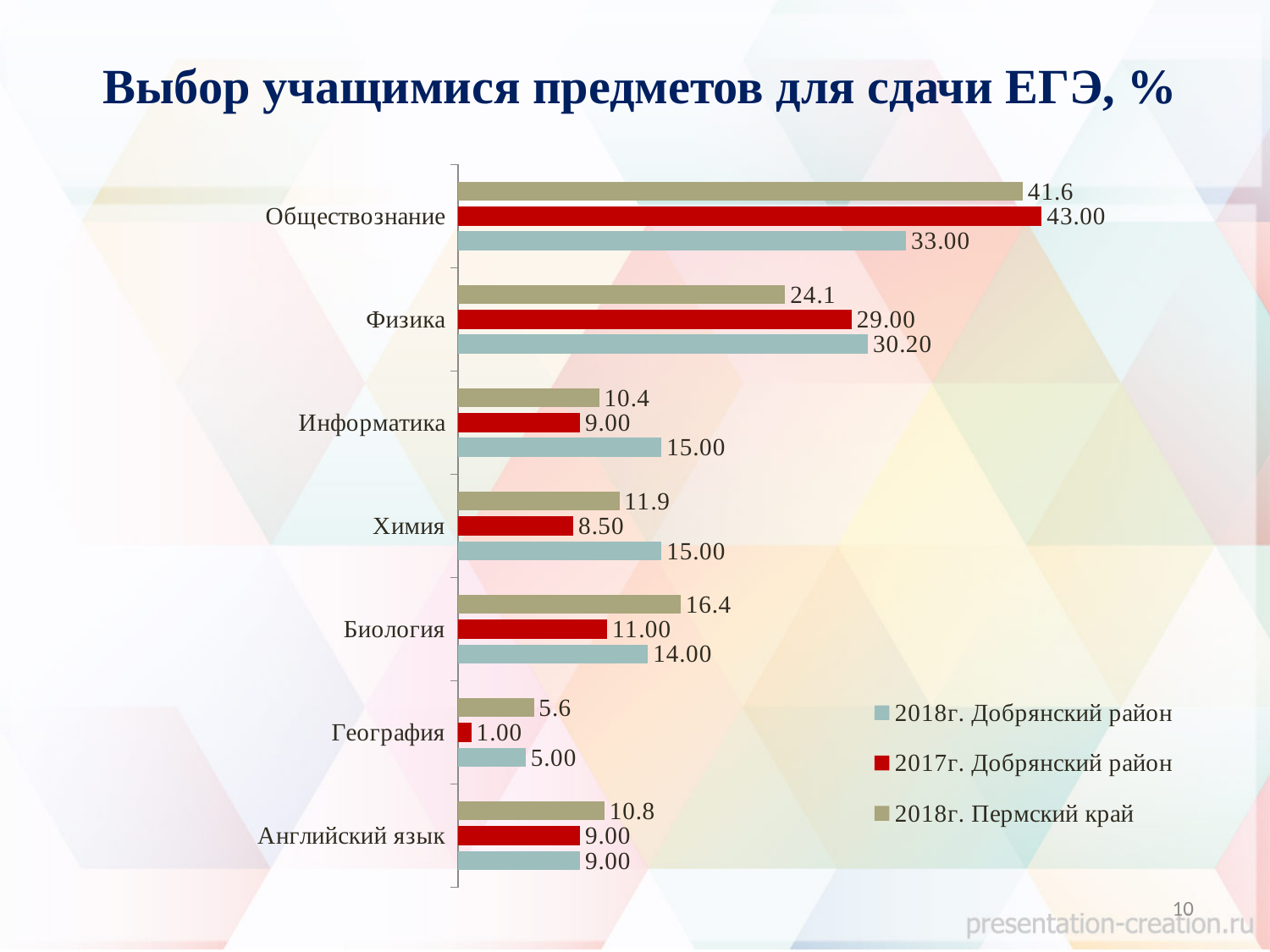
Which subject has the lowest value in the 2017г. Добрянский район series? География For Химия, which is larger: the 2017г. Добрянский район value or the 2018г. Добрянский район value? 2018г. Добрянский район What is the difference between the 2018г. Добрянский район and 2017г. Добрянский район values for Информатика? 6.00 What is the value for Обществознание in the 2017г. Добрянский район series? 43.00 How many subjects are shown on the chart? 7 What kind of chart is shown on the slide? Bar chart How many series does the legend list? 3 What is the value for География in the 2018г. Добрянский район series? 5.00 What is the value for Физика in the 2018г. Пермский край series? 24.1 What is the title of the slide? Выбор учащимися предметов для сдачи ЕГЭ, % Which subject has the highest value in the 2018г. Добрянский район series? Обществознание For Биология, which is larger: the 2018г. Пермский край value or the 2018г. Добрянский район value? 2018г. Пермский край